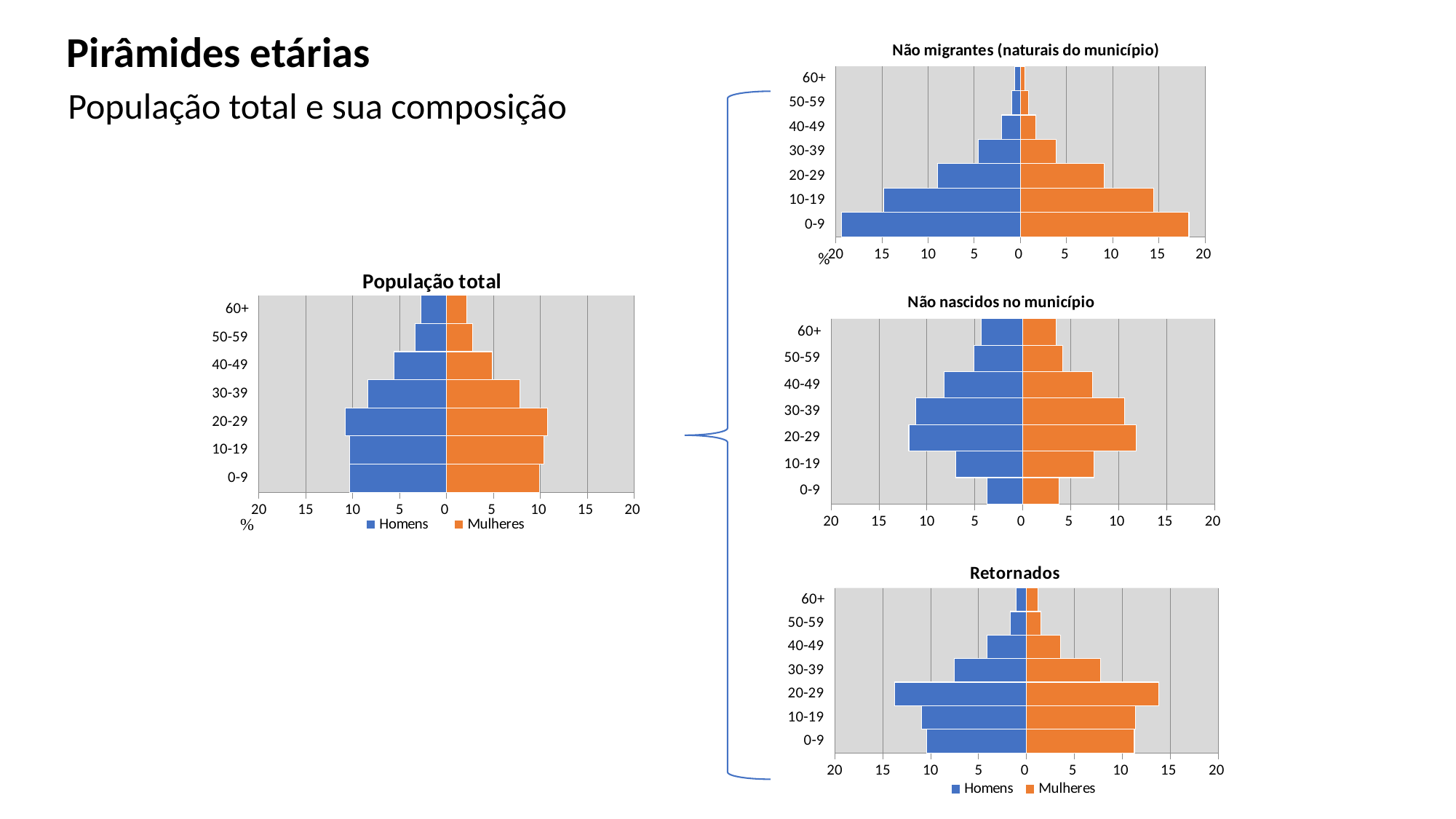
In the 'População total' chart, is the Homens value for the 60+ age group greater or less than 5? less In the 'Não migrantes (naturais do município)' chart, do the Homens bars get longer or shorter moving from the 0-9 group up to the 60+ group? shorter In the 'População total' chart, how many age groups are shown on the vertical axis? 7 In the 'Não migrantes (naturais do município)' chart, is the Mulheres value for the 0-9 age group greater or less than 15? greater In the 'População total' chart, which colour represents the Mulheres series? orange What is the title of the chart at the bottom right of the slide? Retornados What kind of chart is the 'Retornados' chart? bar chart In the 'População total' chart, how many series does the legend list? 2 In the 'Retornados' chart, which is larger: the Mulheres bar for 0-9 or the Mulheres bar for 60+? 0-9 In the 'Não nascidos no município' chart, which age group has the shortest Homens bar? 0-9 In the 'Retornados' chart, which age group has the longest Mulheres bar? 20-29 In the 'Não migrantes (naturais do município)' chart, which age group has the longest Mulheres bar? 0-9